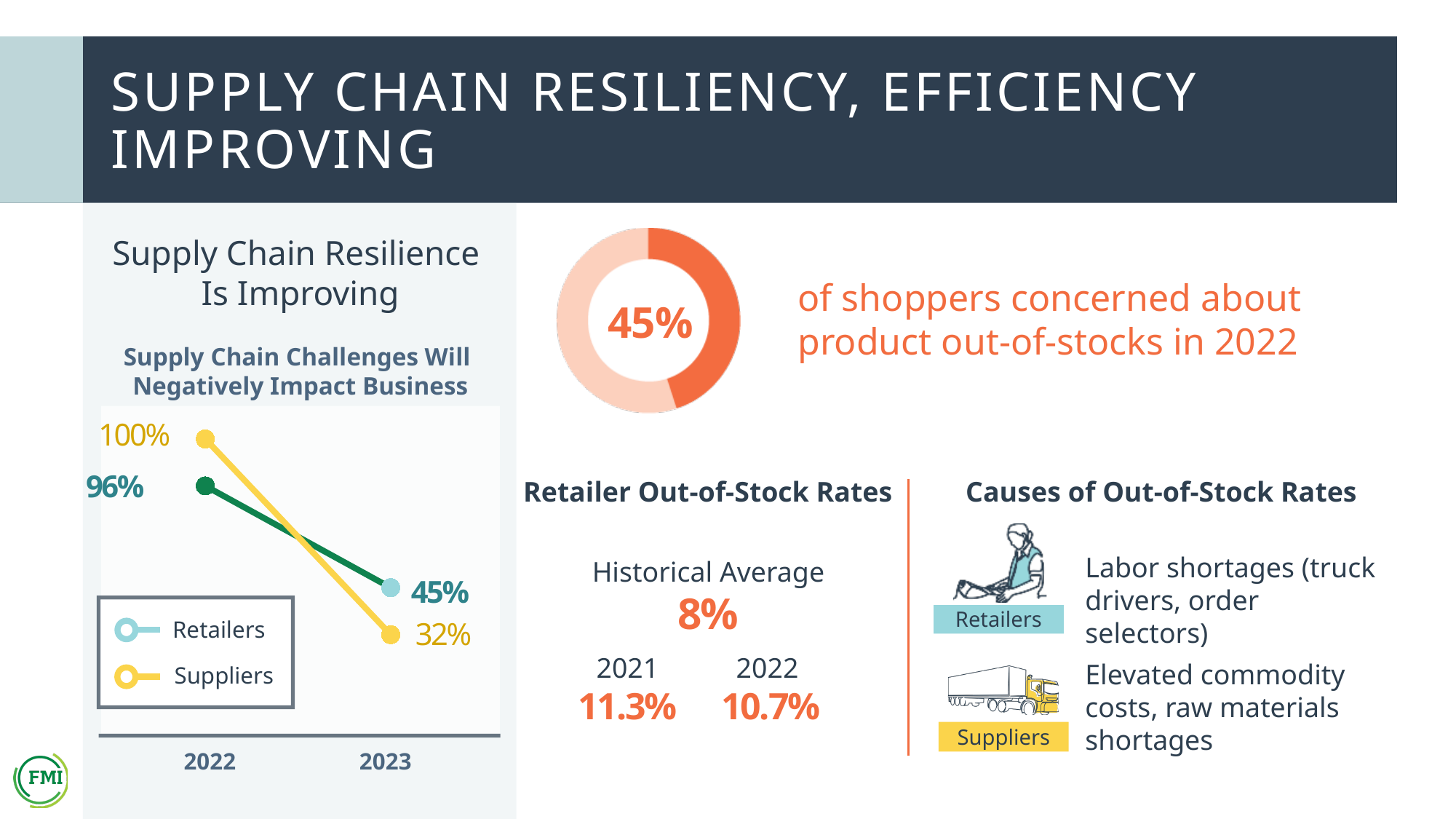
In the 'Supply Chain Challenges Will Negatively Impact Business' chart, what is the value for Retailers in 2023? 45% How many series does the legend of the 'Supply Chain Challenges Will Negatively Impact Business' chart list? 2 What kind of chart is 'Supply Chain Challenges Will Negatively Impact Business'? Line chart In the 'Supply Chain Challenges Will Negatively Impact Business' chart, what is the value for Suppliers in 2023? 32% In the 'Supply Chain Challenges Will Negatively Impact Business' chart, which series has the higher value in 2023, Retailers or Suppliers? Retailers In the 'Supply Chain Challenges Will Negatively Impact Business' chart, what colour is the Suppliers line? Yellow In the 'Supply Chain Challenges Will Negatively Impact Business' chart, by how many percentage points did the Retailers value fall from 2022 to 2023? 51 percentage points In the 'Supply Chain Challenges Will Negatively Impact Business' chart, what is the value for Suppliers in 2022? 100% In the 'Supply Chain Challenges Will Negatively Impact Business' chart, what is the value for Retailers in 2022? 96% In the 'Supply Chain Challenges Will Negatively Impact Business' chart, by how many percentage points did the Suppliers value fall from 2022 to 2023? 68 percentage points What percentage is shown in the donut chart on the right side of the slide? 45% In the 'Supply Chain Challenges Will Negatively Impact Business' chart, do the values rise or fall from 2022 to 2023? Fall